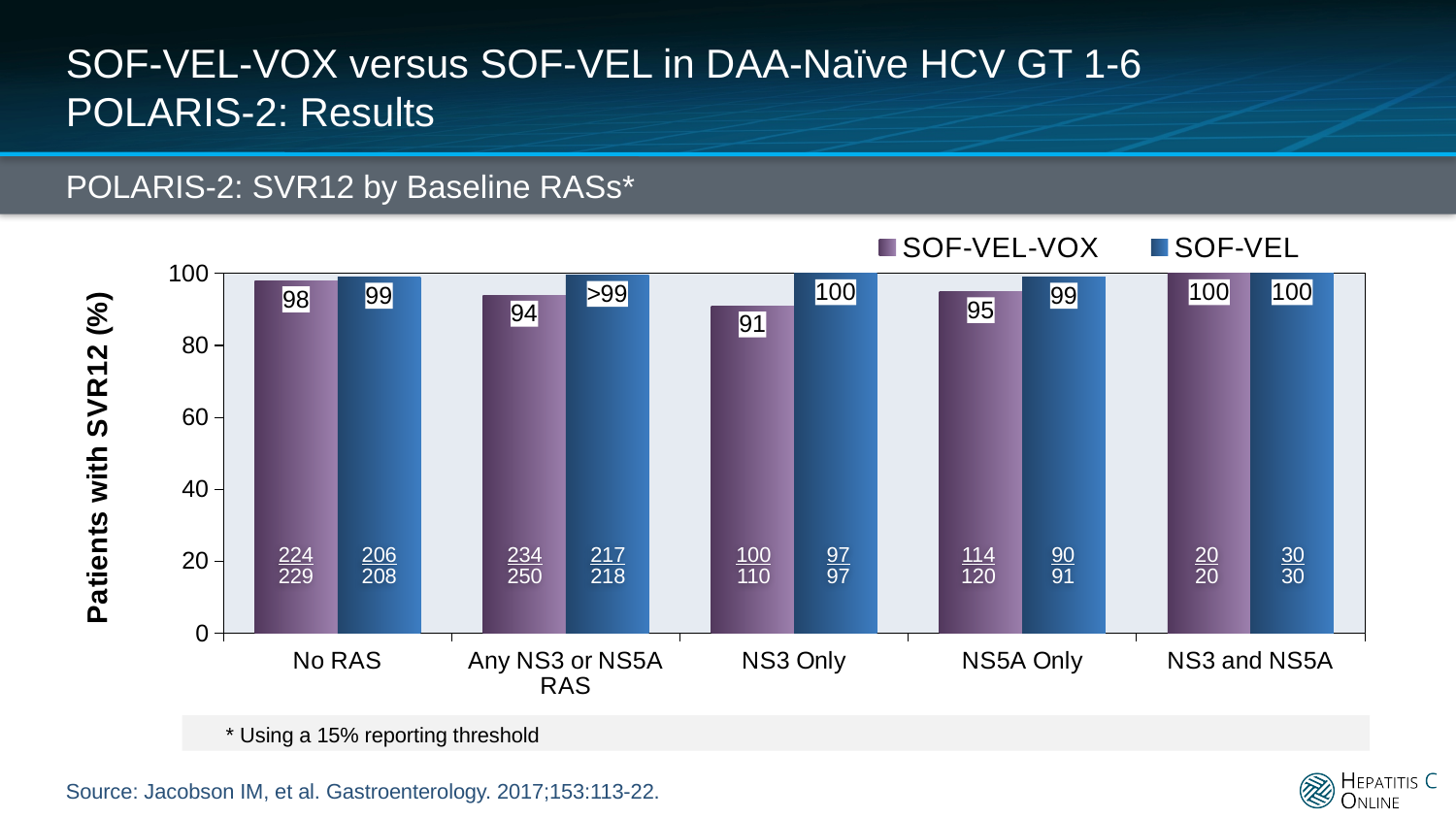
What fraction of patients is shown for SOF-VEL in the NS5A Only group? 90/91 What is the difference between the SOF-VEL and SOF-VEL-VOX SVR12 rates in the NS3 Only group? 9 What is the SVR12 rate for SOF-VEL in the Any NS3 or NS5A RAS group? >99 What kind of chart is shown on the slide? Bar chart How many baseline RAS categories are shown on the x axis? 5 Which series is shown in blue in the legend? SOF-VEL Which baseline RAS category has the lowest SVR12 rate for SOF-VEL-VOX? NS3 Only What is the SVR12 rate for SOF-VEL-VOX in the NS3 Only group? 91 In the NS5A Only group, which regimen has the higher SVR12 rate? SOF-VEL What is the label of the y axis? Patients with SVR12 (%) How many series does the legend list? 2 What is the SVR12 rate for SOF-VEL-VOX in the No RAS group? 98